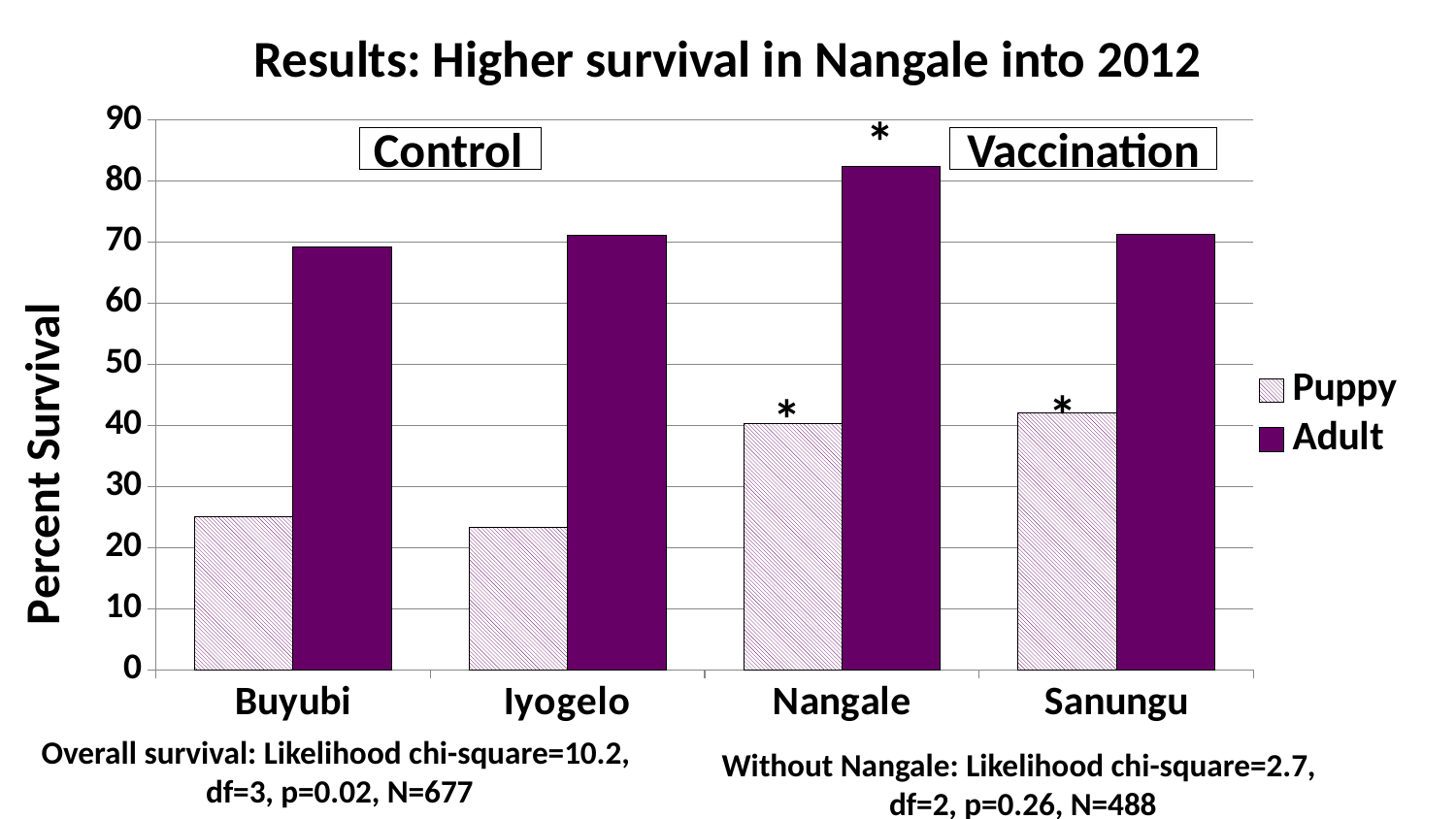
Is the Adult value for Nangale greater or less than 80? greater Is the Adult value for Iyogelo greater or less than 60? greater Is the Puppy value for Buyubi greater or less than 30? less How many series does the legend list? 2 Which village has the highest Adult percent survival? Nangale Which is larger, the Puppy value for Iyogelo or the Puppy value for Nangale? Nangale How many villages are shown on the x axis? 4 What is the title of the chart? Results: Higher survival in Nangale into 2012 Which is larger, the Adult value for Buyubi or the Adult value for Nangale? Nangale What kind of chart is shown on the slide? bar chart